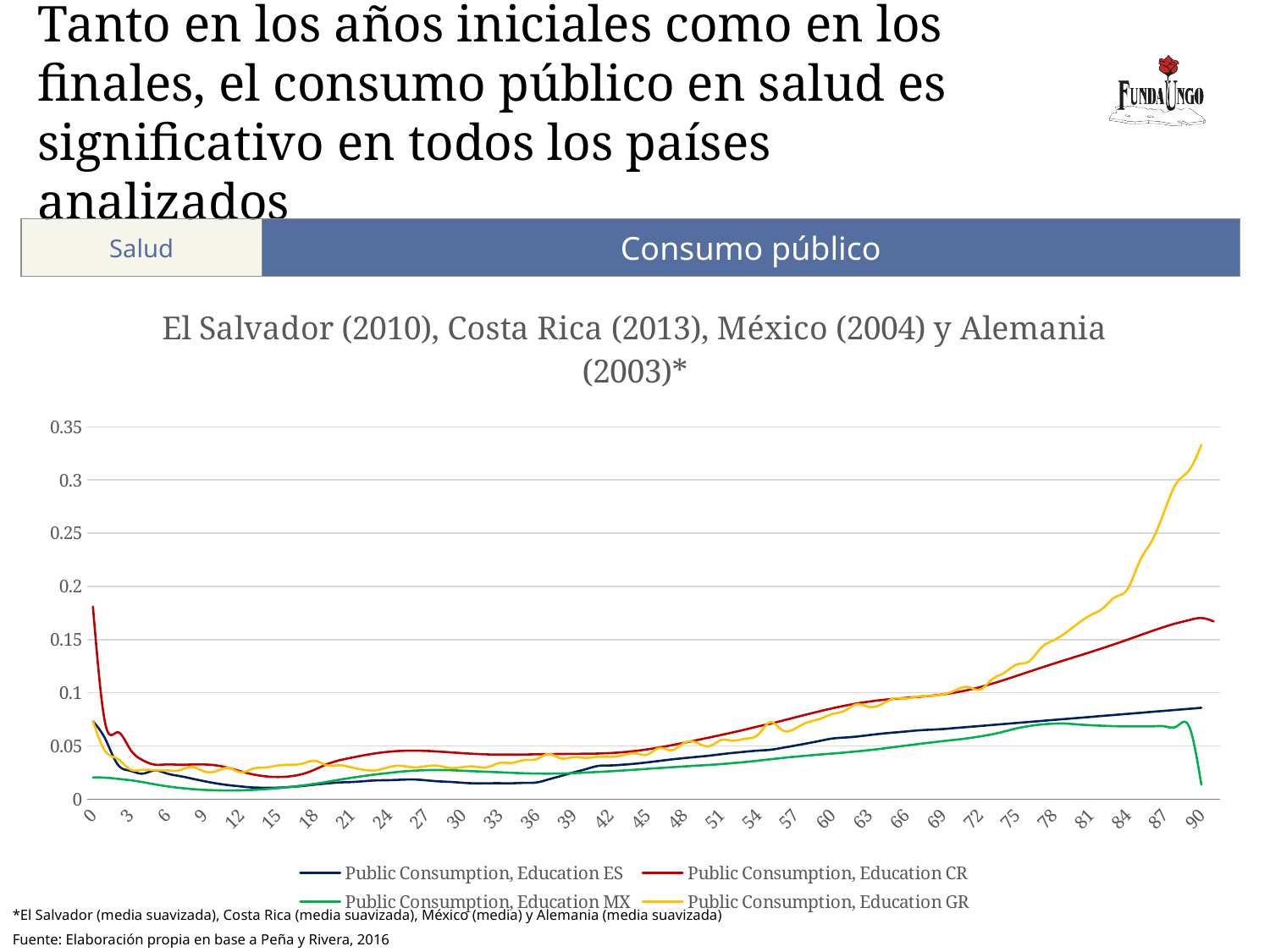
At age 60, which is larger: Public Consumption, Education CR or Public Consumption, Education ES? Public Consumption, Education CR Is the value for Public Consumption, Education ES at age 90 greater or less than 0.1? less What is the title of the chart? El Salvador (2010), Costa Rica (2013), México (2004) y Alemania (2003)* Which series has the lowest value at age 90? Public Consumption, Education MX Is the value for Public Consumption, Education CR at age 0 greater or less than 0.15? greater Which colour is used for the Public Consumption, Education GR line? yellow Which series has the highest value at age 0? Public Consumption, Education CR Which series has the highest value at age 90? Public Consumption, Education GR What kind of chart is shown on the slide? line chart Does the Public Consumption, Education GR line rise or fall between age 60 and age 90? rise Is the value for Public Consumption, Education GR at age 90 greater or less than 0.3? greater How many series does the legend list? 4